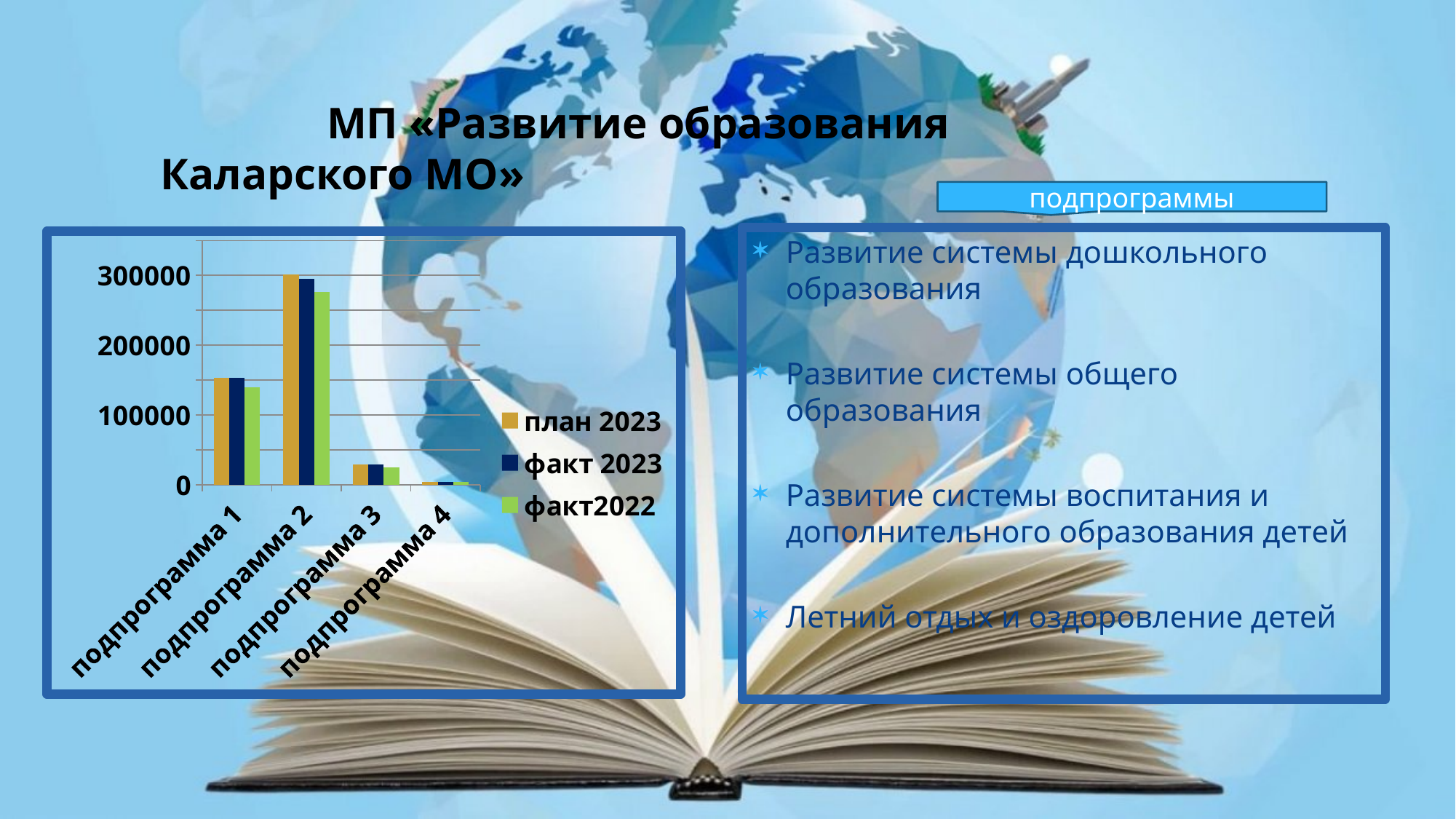
Which is larger: факт2022 for подпрограмма 3 or факт2022 for подпрограмма 1? подпрограмма 1 Which category has the lowest values in the chart? подпрограмма 4 How many series does the chart legend list? 3 Is the value of план 2023 for подпрограмма 3 greater or less than 100000? less Is the value of факт 2023 for подпрограмма 4 greater or less than 100000? less How many categories are shown on the x axis of the chart? 4 Is the value of план 2023 for подпрограмма 1 greater or less than 100000? greater Which is larger: план 2023 for подпрограмма 2 or план 2023 for подпрограмма 1? подпрограмма 2 What kind of chart is shown on the slide? bar chart Which category has the highest values in the chart? подпрограмма 2 What are the three series listed in the chart legend? план 2023, факт 2023, факт2022